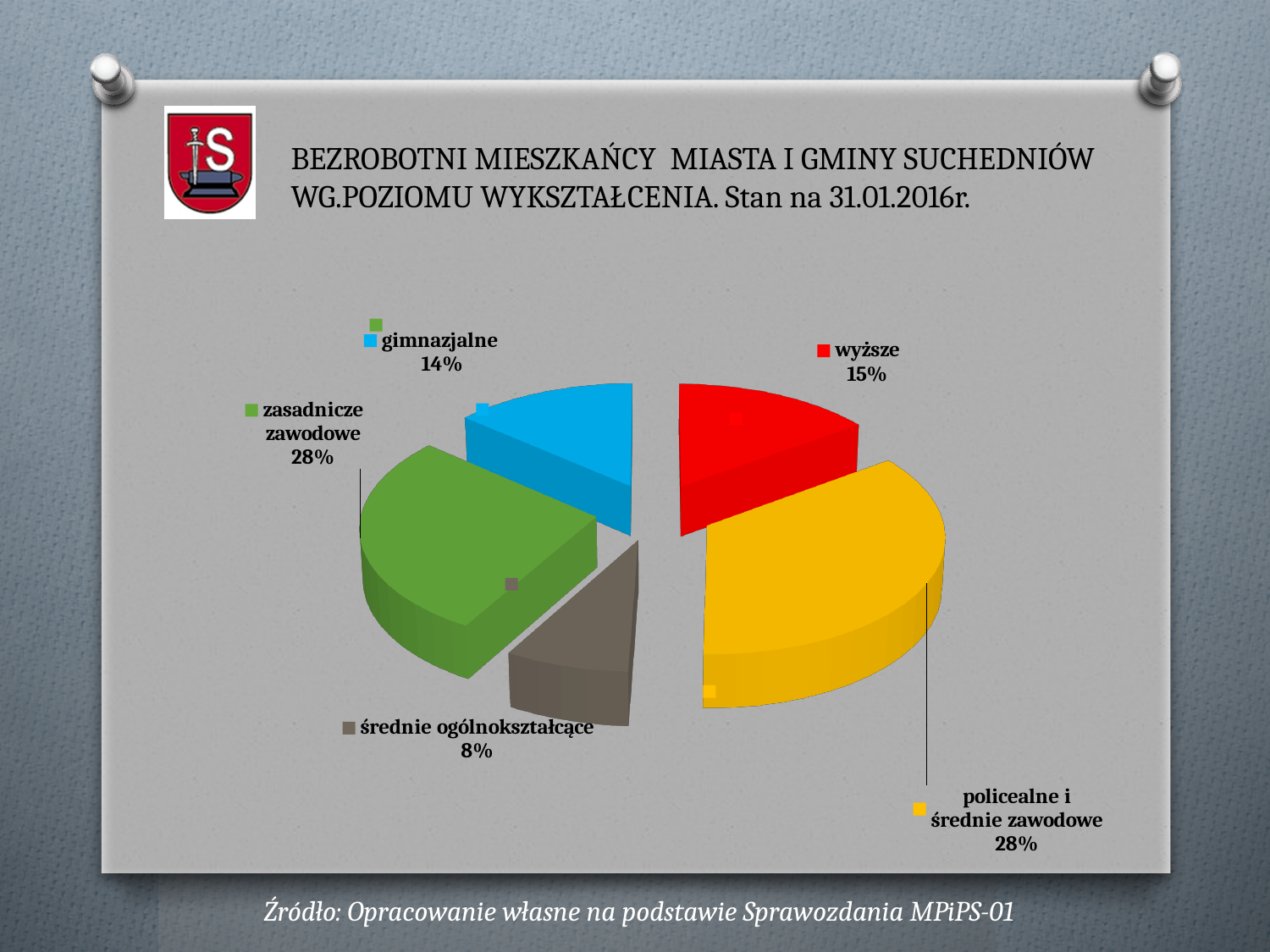
What is the difference in percentage points between 'zasadnicze zawodowe' and 'średnie ogólnokształcące'? 20 percentage points What percentage is shown for 'policealne i średnie zawodowe'? 28% What percentage is shown for 'zasadnicze zawodowe'? 28% What percentage is shown for 'gimnazjalne'? 14% What percentage is shown for 'średnie ogólnokształcące'? 8% How many labelled categories are shown in the pie chart? 5 Which category has the smallest share of the pie? średnie ogólnokształcące What is the difference in percentage points between 'wyższe' and 'gimnazjalne'? 1 percentage point What share of the pie does the 'wyższe' slice represent? 15% Which is larger, the share for 'wyższe' or for 'gimnazjalne'? wyższe What type of chart is shown on the slide? Pie chart Which is larger, the share for 'zasadnicze zawodowe' or for 'średnie ogólnokształcące'? zasadnicze zawodowe